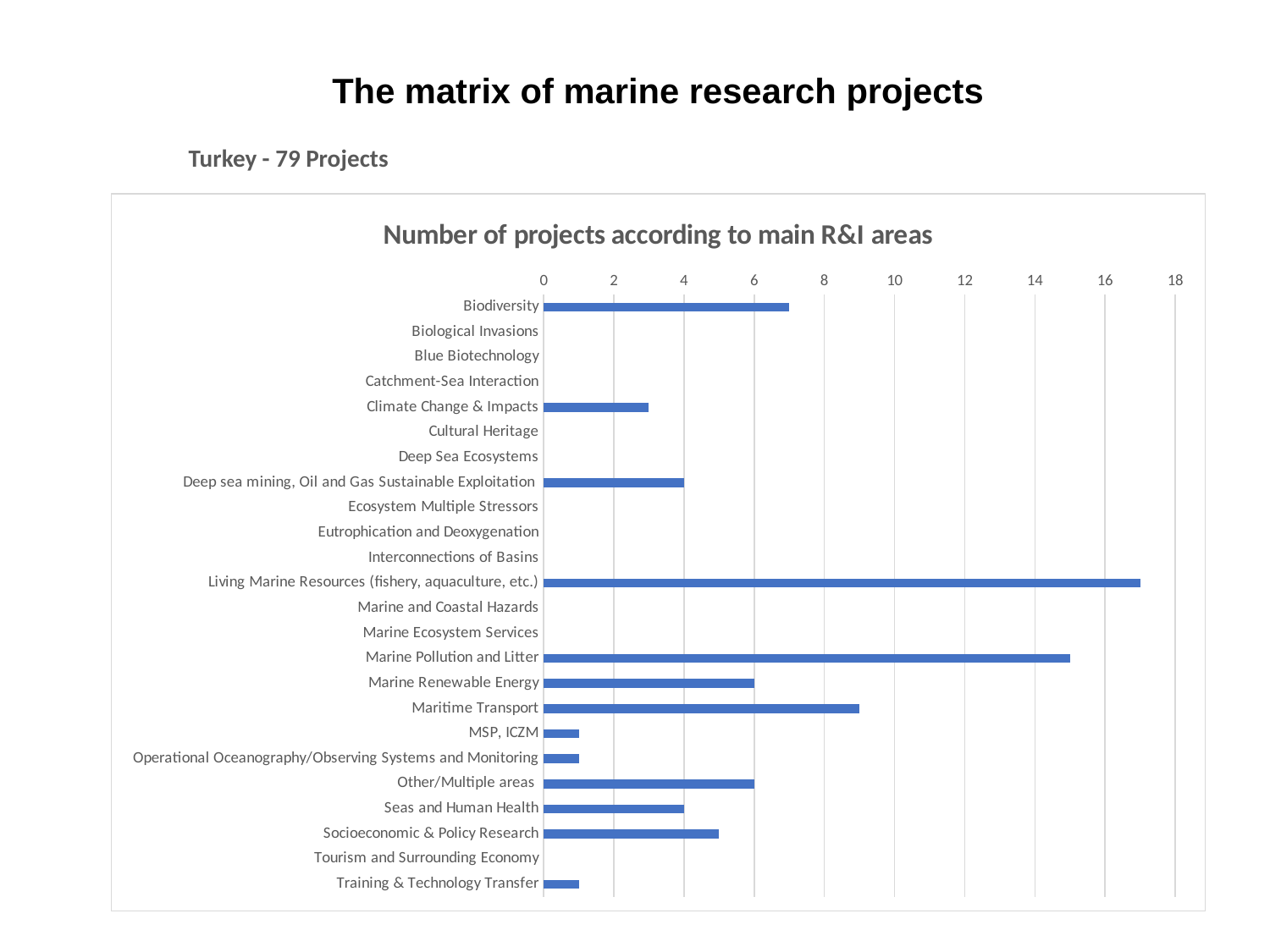
What kind of chart is shown on the slide? bar chart Which R&I area has the highest number of projects? Living Marine Resources (fishery, aquaculture, etc.) Is the value for Living Marine Resources (fishery, aquaculture, etc.) greater or less than 16? greater What is the number of projects for Marine Renewable Energy? 6 What is the number of projects for Seas and Human Health? 4 Which has more projects, Socioeconomic & Policy Research or Training & Technology Transfer? Socioeconomic & Policy Research What is the number of projects for Deep sea mining, Oil and Gas Sustainable Exploitation? 4 How many R&I area categories are listed on the chart's axis? 24 What is the title of the chart? Number of projects according to main R&I areas Which has more projects, Marine Pollution and Litter or Maritime Transport? Marine Pollution and Litter Is the value for Biodiversity greater or less than 6? greater Is the value for Climate Change & Impacts greater or less than 4? less